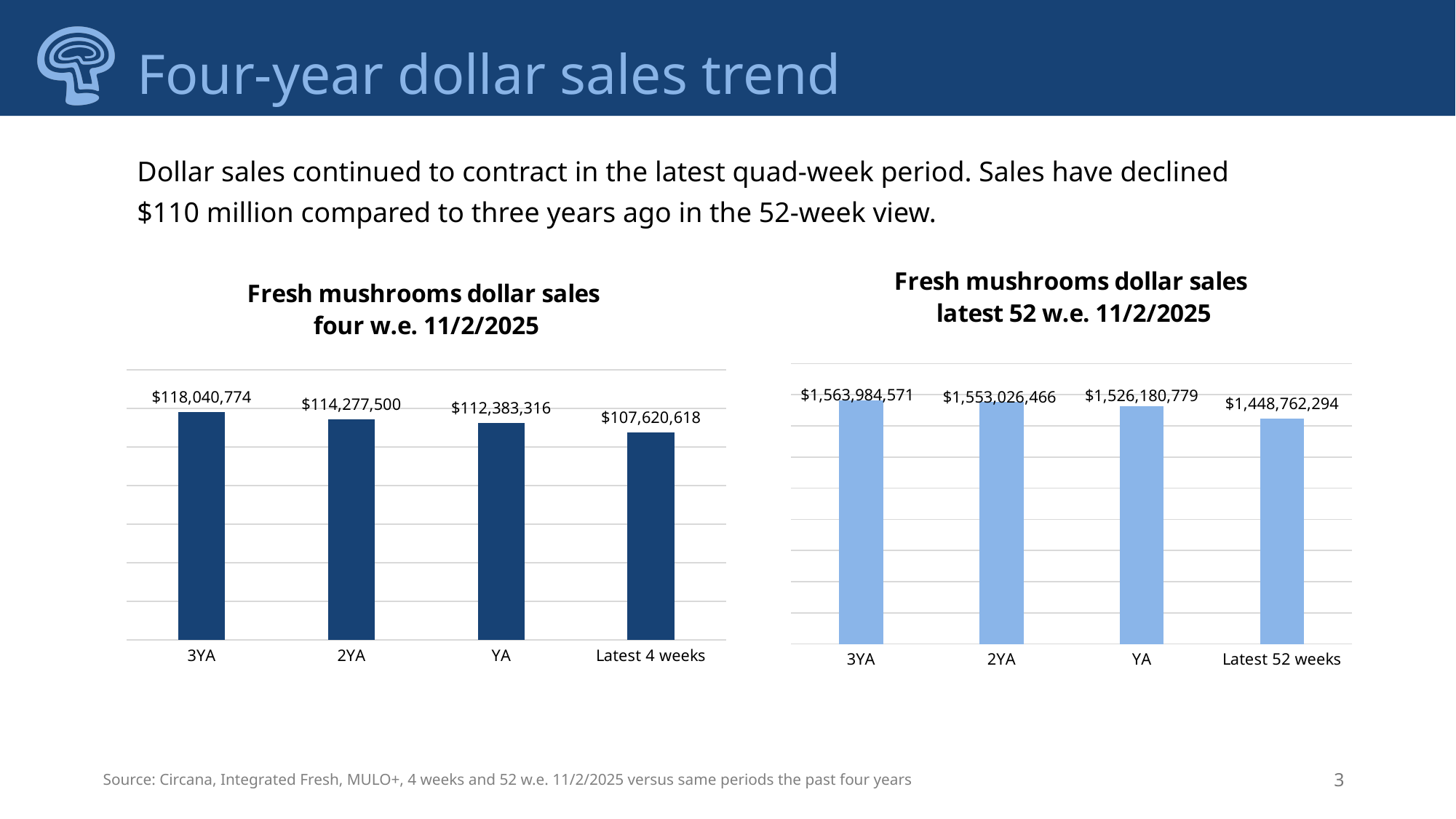
In the 'Fresh mushrooms dollar sales latest 52 w.e. 11/2/2025' chart, do the values rise or fall from 3YA to Latest 52 weeks? Fall In the 'Fresh mushrooms dollar sales latest 52 w.e. 11/2/2025' chart, what is the value for YA? $1,526,180,779 In the 'Fresh mushrooms dollar sales four w.e. 11/2/2025' chart, which is larger, 2YA or YA? 2YA In the 'Fresh mushrooms dollar sales latest 52 w.e. 11/2/2025' chart, which period has the lowest value? Latest 52 weeks In the 'Fresh mushrooms dollar sales four w.e. 11/2/2025' chart, what is the value for Latest 4 weeks? $107,620,618 In the 'Fresh mushrooms dollar sales latest 52 w.e. 11/2/2025' chart, what is the value for Latest 52 weeks? $1,448,762,294 In the 'Fresh mushrooms dollar sales four w.e. 11/2/2025' chart, what is the difference between 3YA and Latest 4 weeks? $10,420,156 What kind of chart is the 'Fresh mushrooms dollar sales four w.e. 11/2/2025' chart? Bar chart In the 'Fresh mushrooms dollar sales four w.e. 11/2/2025' chart, which period has the highest value? 3YA In the 'Fresh mushrooms dollar sales latest 52 w.e. 11/2/2025' chart, what is the difference between 3YA and Latest 52 weeks? $115,222,277 How many bars are in the 'Fresh mushrooms dollar sales latest 52 w.e. 11/2/2025' chart? 4 In the 'Fresh mushrooms dollar sales four w.e. 11/2/2025' chart, what is the value for 3YA? $118,040,774